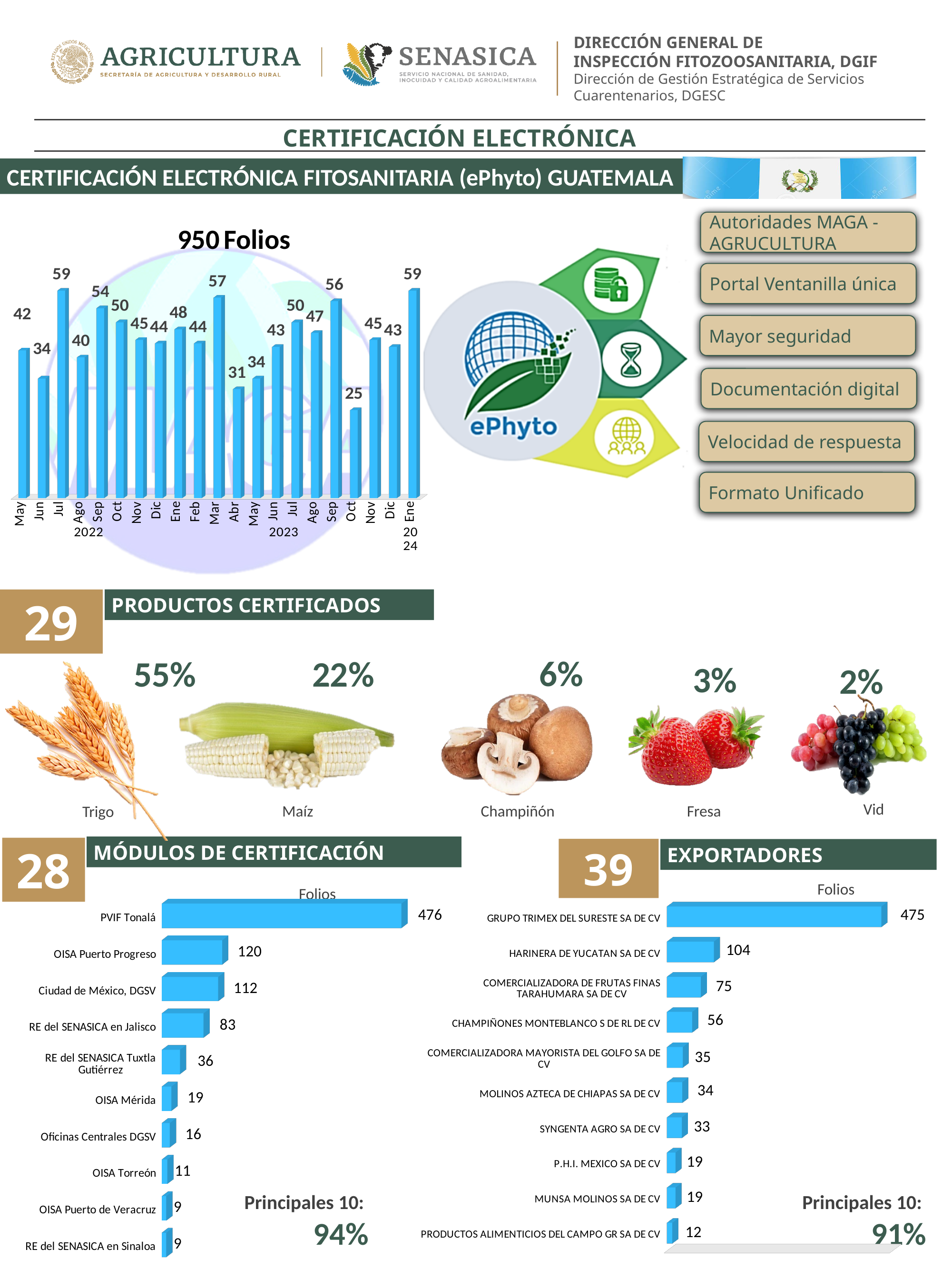
In the 'Exportadores' chart, what is the value for HARINERA DE YUCATAN SA DE CV? 104 In the 'Módulos de Certificación' chart, what kind of chart is used? Bar chart In the '950 Folios' monthly chart, what is the difference between Jul 2022 and Jun 2022? 25 In the 'Módulos de Certificación' chart, what is the difference between PVIF Tonalá and OISA Puerto Progreso? 356 In the 'Módulos de Certificación' chart, which module has the highest number of folios? PVIF Tonalá In the '950 Folios' monthly chart, how many monthly bars are plotted? 21 In the 'Módulos de Certificación' chart, what is the value for PVIF Tonalá? 476 In the 'Exportadores' chart, how many exporters are listed? 10 In the '950 Folios' monthly chart, what is the value for Mar 2023? 57 In the '950 Folios' monthly chart, what is the value for Oct 2023? 25 In the 'Exportadores' chart, which exporter has the lowest number of folios? PRODUCTOS ALIMENTICIOS DEL CAMPO GR SA DE CV In the '950 Folios' monthly chart, which month has the lowest value? Oct 2023